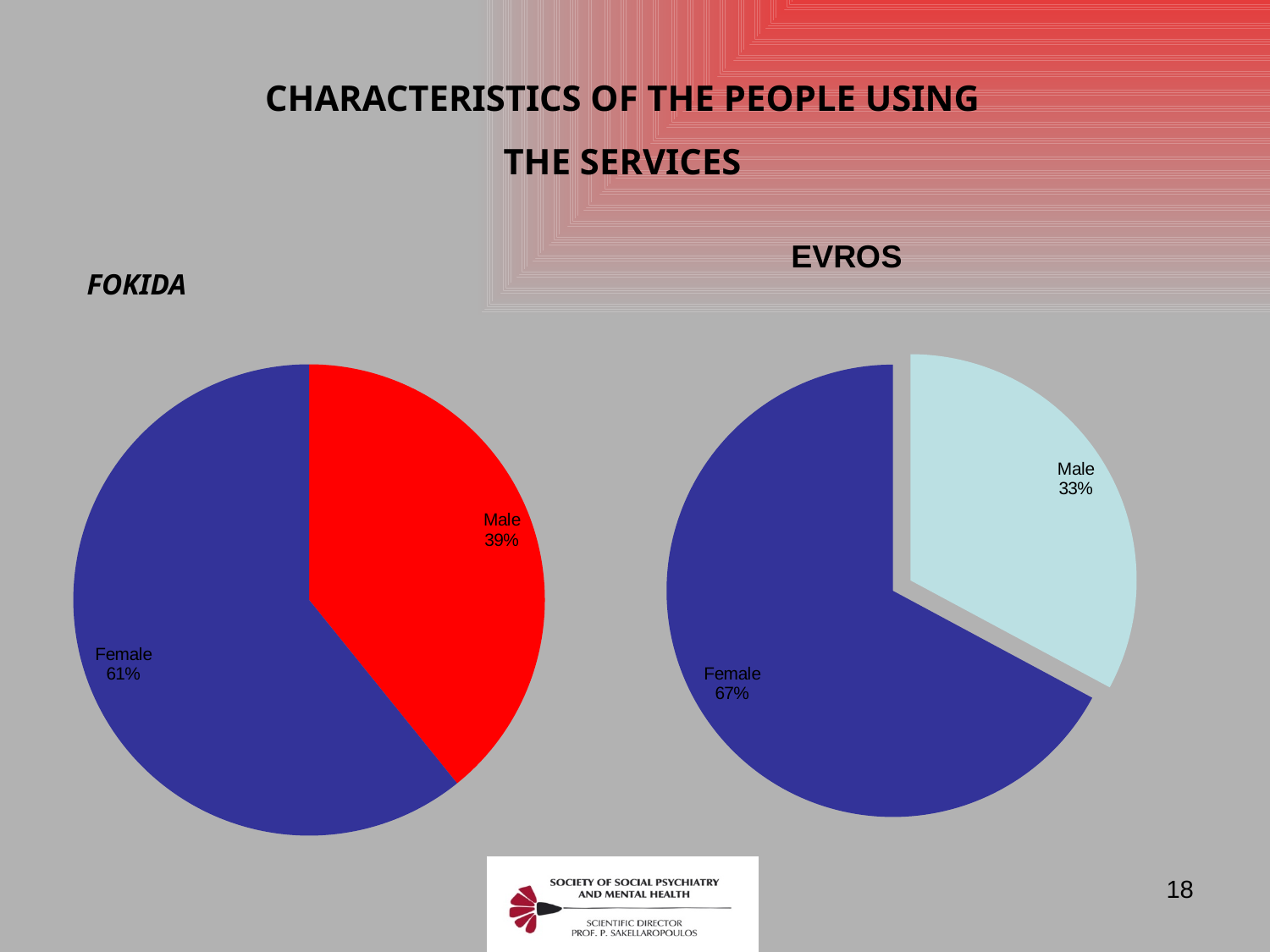
How many categories does the EVROS chart show? 2 In the FOKIDA chart, what colour is the Male slice? Red In the EVROS chart, what is the difference between the Female and Male shares? 34% Which is larger: the Male share in the FOKIDA chart or the Male share in the EVROS chart? FOKIDA In the FOKIDA chart, what share of the pie is Male? 39% In the EVROS chart, what share of the pie is Male? 33% In the FOKIDA chart, what share of the pie is Female? 61% In the FOKIDA chart, what is the difference between the Female and Male shares? 22% In the FOKIDA chart, which category has the largest slice? Female What kind of chart is the FOKIDA chart? Pie chart In the EVROS chart, which category has the smallest slice? Male